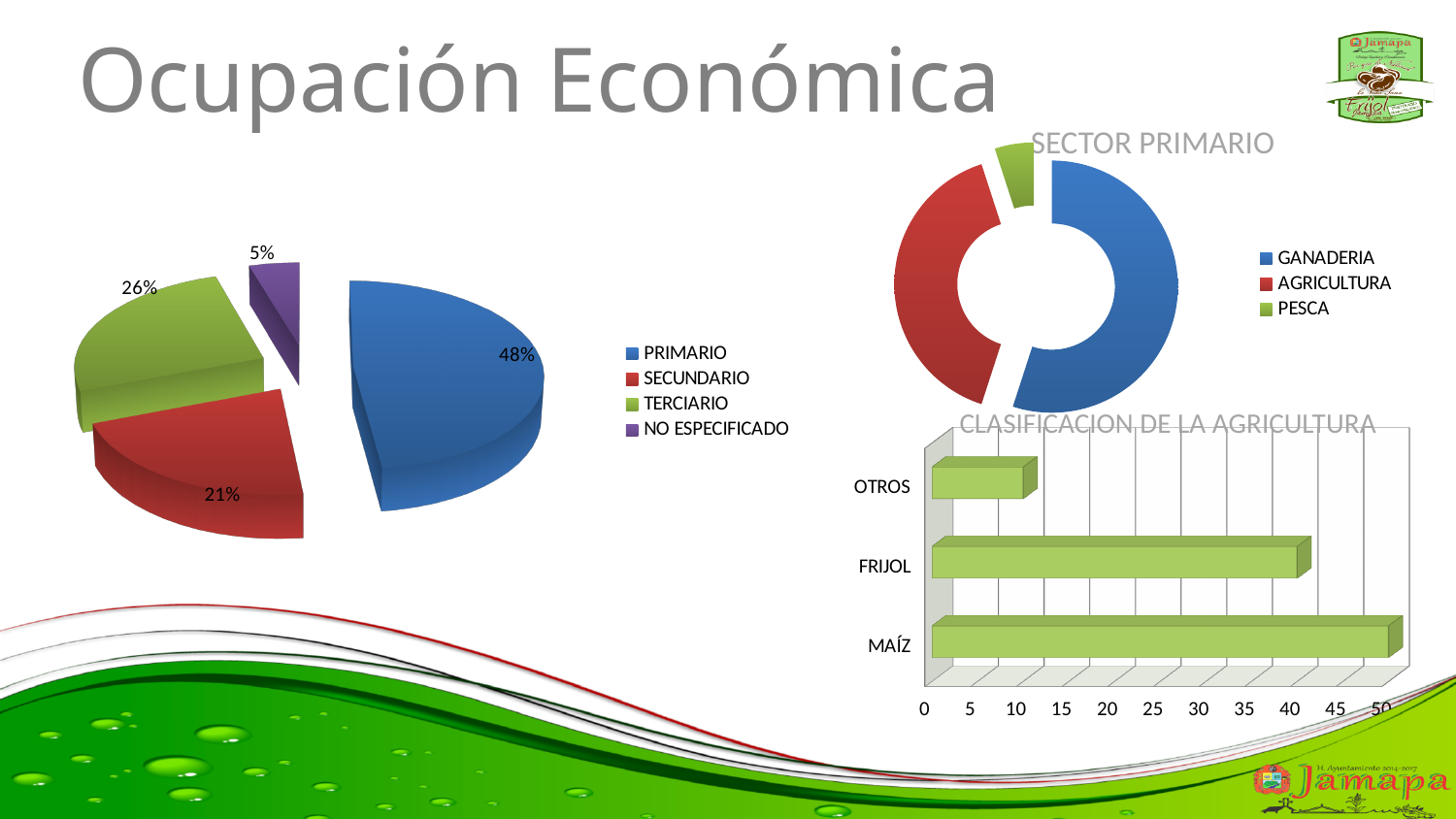
In the SECTOR PRIMARIO chart, which category has the largest share? GANADERIA In the pie chart on the left, what percentage is shown for PRIMARIO? 48% In the pie chart on the left, which category has the smallest share? NO ESPECIFICADO In the pie chart on the left, what percentage is shown for TERCIARIO? 26% How many categories does the legend of the pie chart on the left list? 4 In the pie chart on the left, what is the difference between the PRIMARIO and SECUNDARIO percentages? 27% How many entries does the legend of the SECTOR PRIMARIO chart list? 3 In the SECTOR PRIMARIO chart, which category has the smallest share? PESCA In the CLASIFICACION DE LA AGRICULTURA chart, is the value for OTROS greater or less than 15? less In the pie chart on the left, which category has the largest share? PRIMARIO What kind of chart is CLASIFICACION DE LA AGRICULTURA? Bar chart In the CLASIFICACION DE LA AGRICULTURA chart, which category has the highest value? MAÍZ